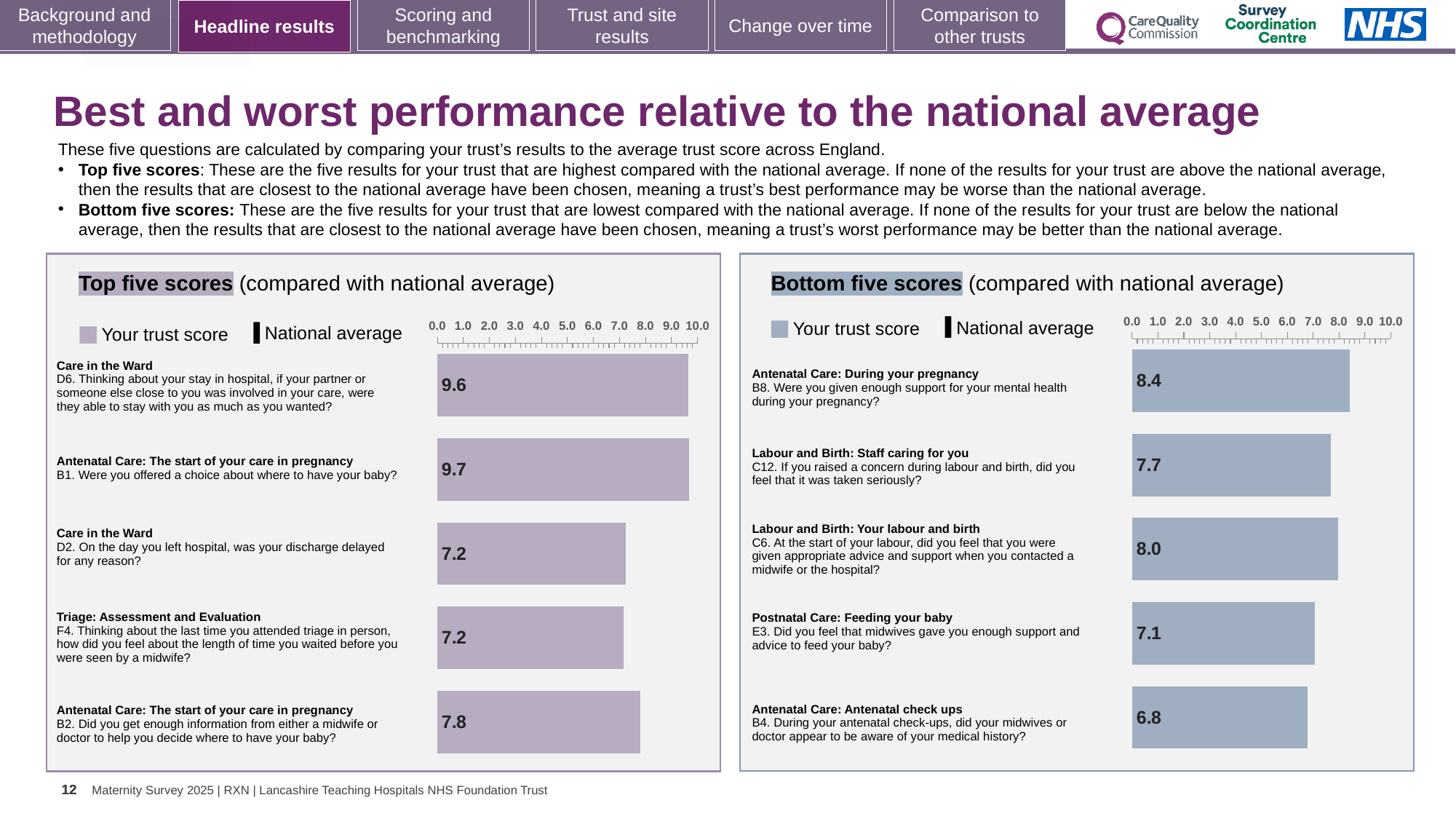
In the Top five scores chart, what is the difference between the scores for B1 and B2? 1.9 In the Top five scores chart, which question has the highest trust score? B1. Were you offered a choice about where to have your baby? What type of chart is used in the Top five scores panel? Bar chart How many series does the legend of the Bottom five scores chart list? 2 In the Bottom five scores chart, which is larger: the score for C12 or the score for C6? C6 In the Bottom five scores chart, which question has the lowest trust score? B4. During your antenatal check-ups, did your midwives or doctor appear to be aware of your medical history? In the Top five scores chart, how many questions are plotted? 5 In the Top five scores chart, what is the trust score for question B1 (Were you offered a choice about where to have your baby?)? 9.7 In the Bottom five scores chart, what is the trust score for question B8 about support for your mental health during pregnancy? 8.4 In the Top five scores chart, what is the trust score for question D6 about your partner being able to stay with you? 9.6 In the Bottom five scores chart, what is the trust score for question E3 about support and advice to feed your baby? 7.1 In the Bottom five scores chart, what is the difference between the scores for B8 and B4? 1.6